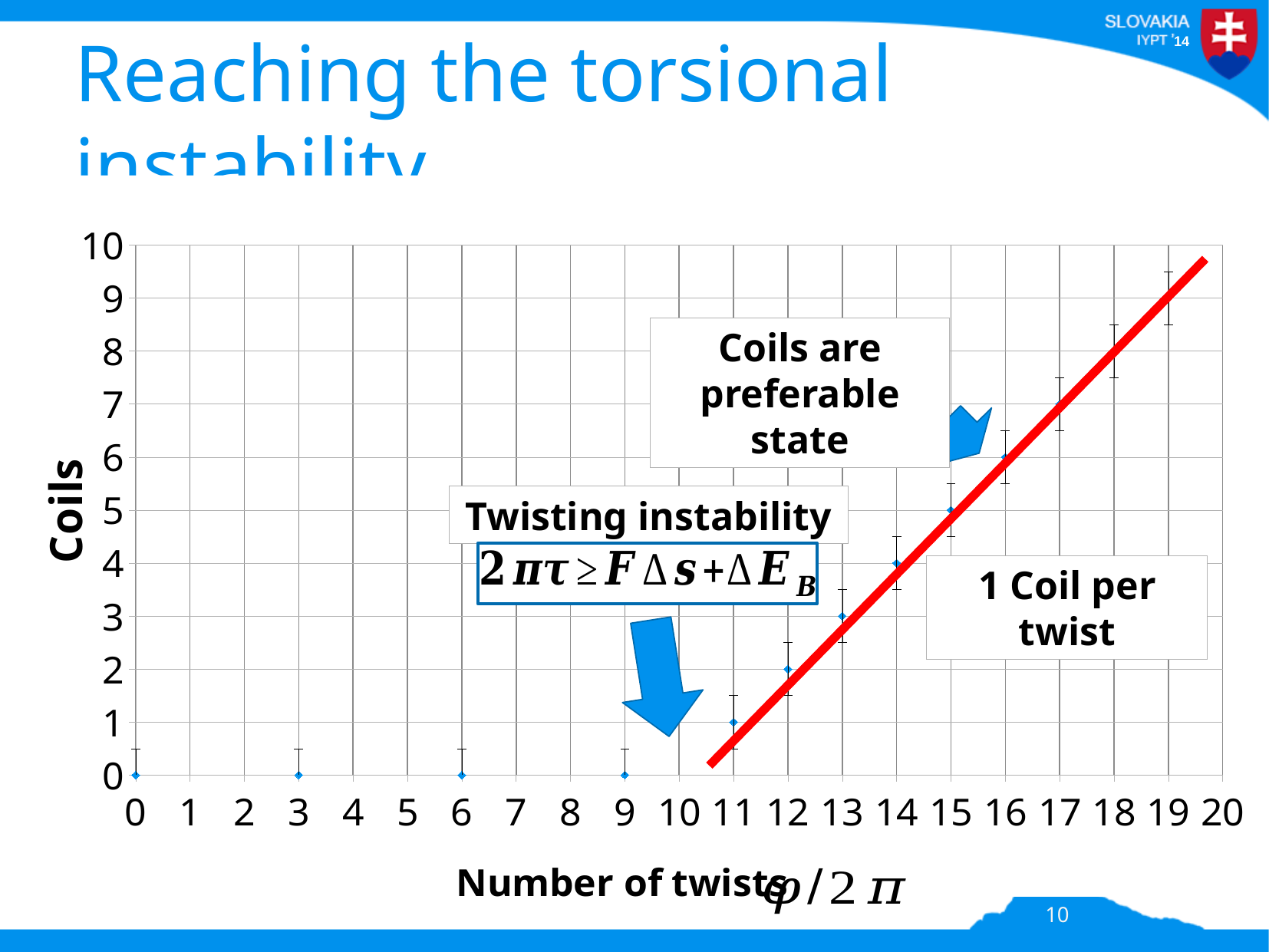
How many data points show 0 coils? 4 How many coils are recorded at 15 twists? 5 What is the difference in coils between 18 twists and 12 twists? 6 Do the number of coils rise or fall as the number of twists increases beyond 10? rise What kind of chart is shown on the slide? scatter chart How many coils are recorded at 9 twists? 0 How many coils are recorded at 19 twists? 9 At which number of twists is the number of coils highest? 19 Which has more coils: 14 twists or 11 twists? 14 twists Is the number of coils at 17 twists greater or less than 5? greater What does the annotation next to the red line say about the rate of coiling? 1 Coil per twist What is the label of the vertical axis? Coils